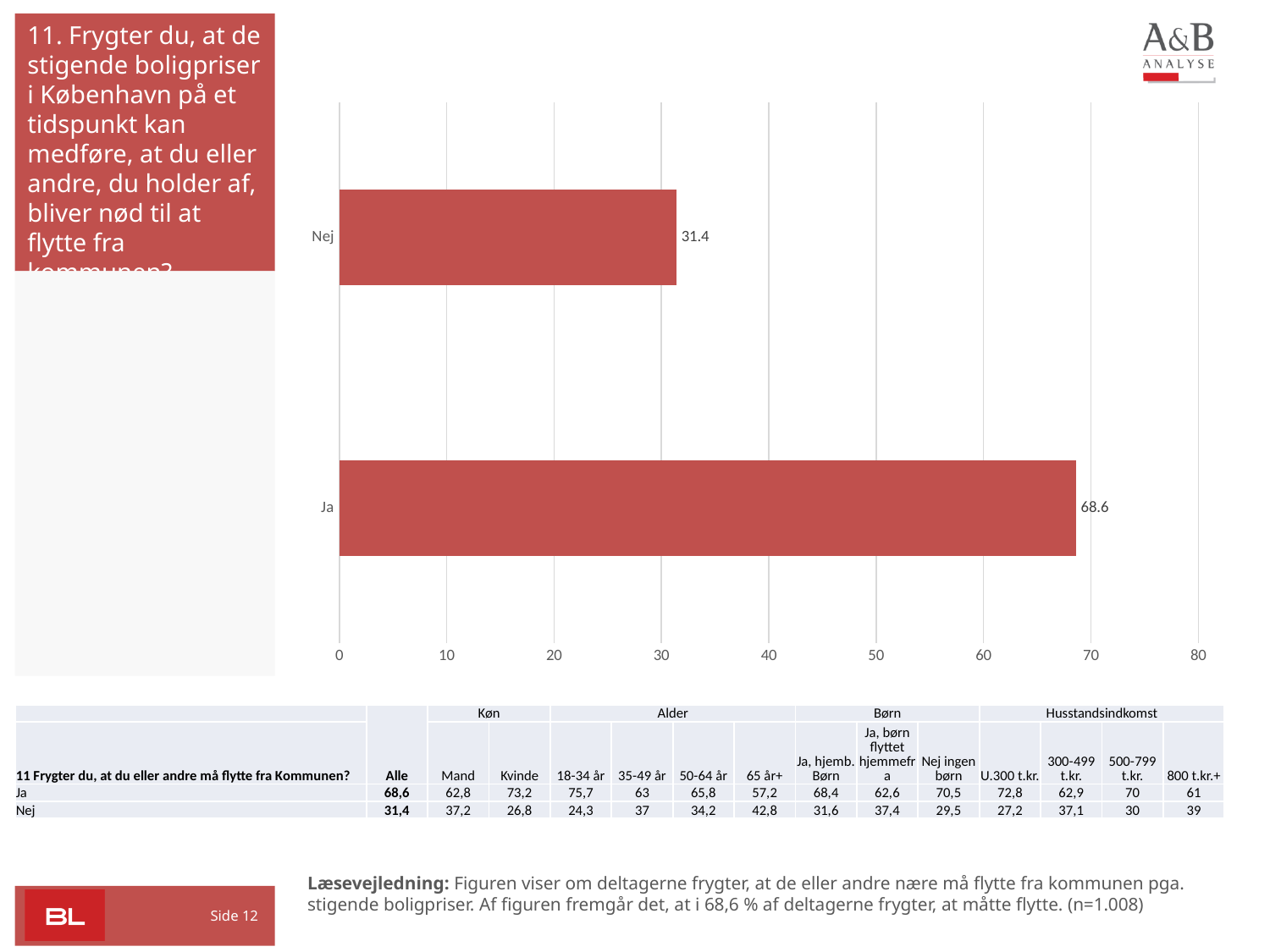
What is the total of the values for "Ja" and "Nej"? 100 Which category has the highest value in the chart? Ja What kind of chart is shown on the slide? bar chart Which category has the lowest value in the chart? Nej How many categories are shown in the chart? 2 Is the value for "Nej" greater or less than 40? less Is the value for "Ja" greater or less than 60? greater What is the difference between the values for "Ja" and "Nej"? 37.2 What is the value for "Ja" in the chart? 68.6 What is the value for "Nej" in the chart? 31.4 Which is larger, the value for "Ja" or the value for "Nej"? Ja What is the highest value shown on the chart's horizontal axis? 80